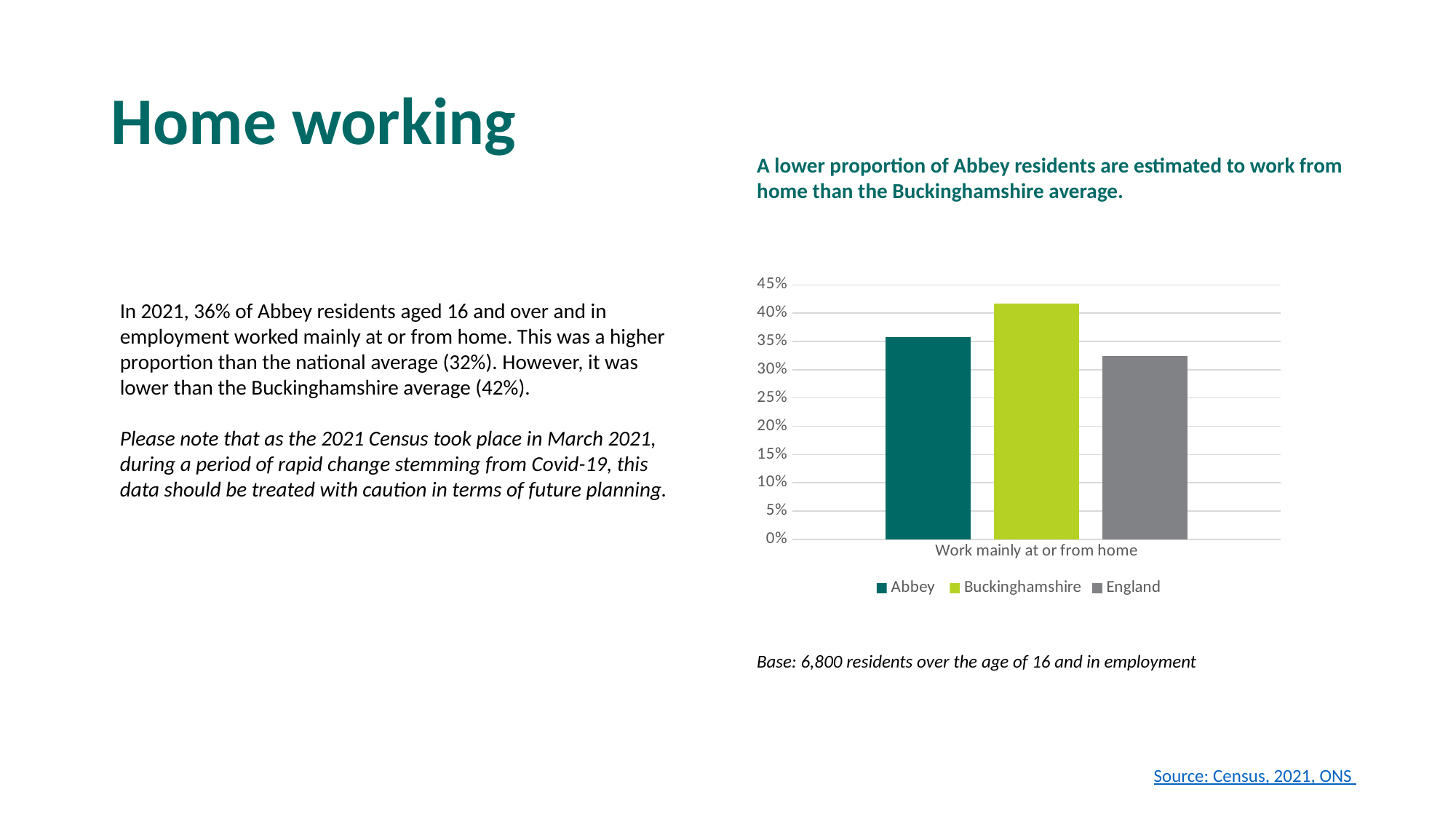
Which area has the lowest proportion working mainly at or from home in the chart? England Is the value for England greater or less than 30%? greater How many series does the chart legend list? 3 Which area has the highest proportion working mainly at or from home in the chart? Buckinghamshire Is the value for England greater or less than 35%? less What kind of chart is shown on the slide? bar chart Is the value for Buckinghamshire greater or less than 35%? greater What is the highest value shown on the chart's y axis? 45% Is the bar for Abbey higher or lower than the bar for Buckinghamshire? lower What is the category label shown on the x axis of the chart? Work mainly at or from home Is the bar for Abbey higher or lower than the bar for England? higher